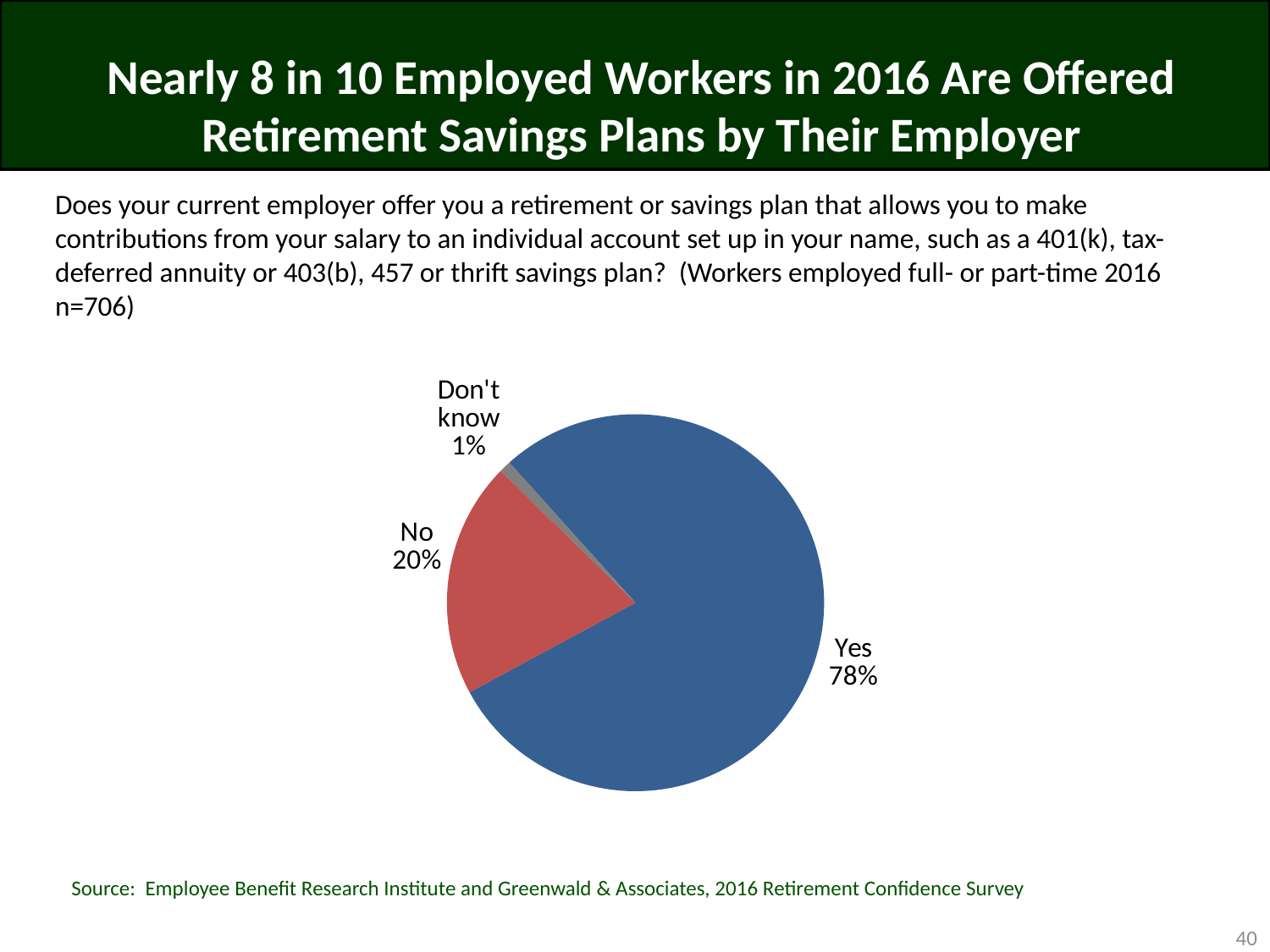
What colour is the "Yes" slice? blue What percentage of workers answered "Yes"? 78% What percentage of workers answered "No"? 20% What percentage of workers answered "Don't know"? 1% Which response has the smallest share of the pie? Don't know What kind of chart is shown on the slide? pie chart Which is larger, the "No" slice or the "Don't know" slice? No Which response has the largest share of the pie? Yes What colour is the "No" slice? red How many slices does the pie chart have? 3 What share of the pie does the "Yes" slice represent? 78% What is the difference in percentage points between the "Yes" and "No" slices? 58